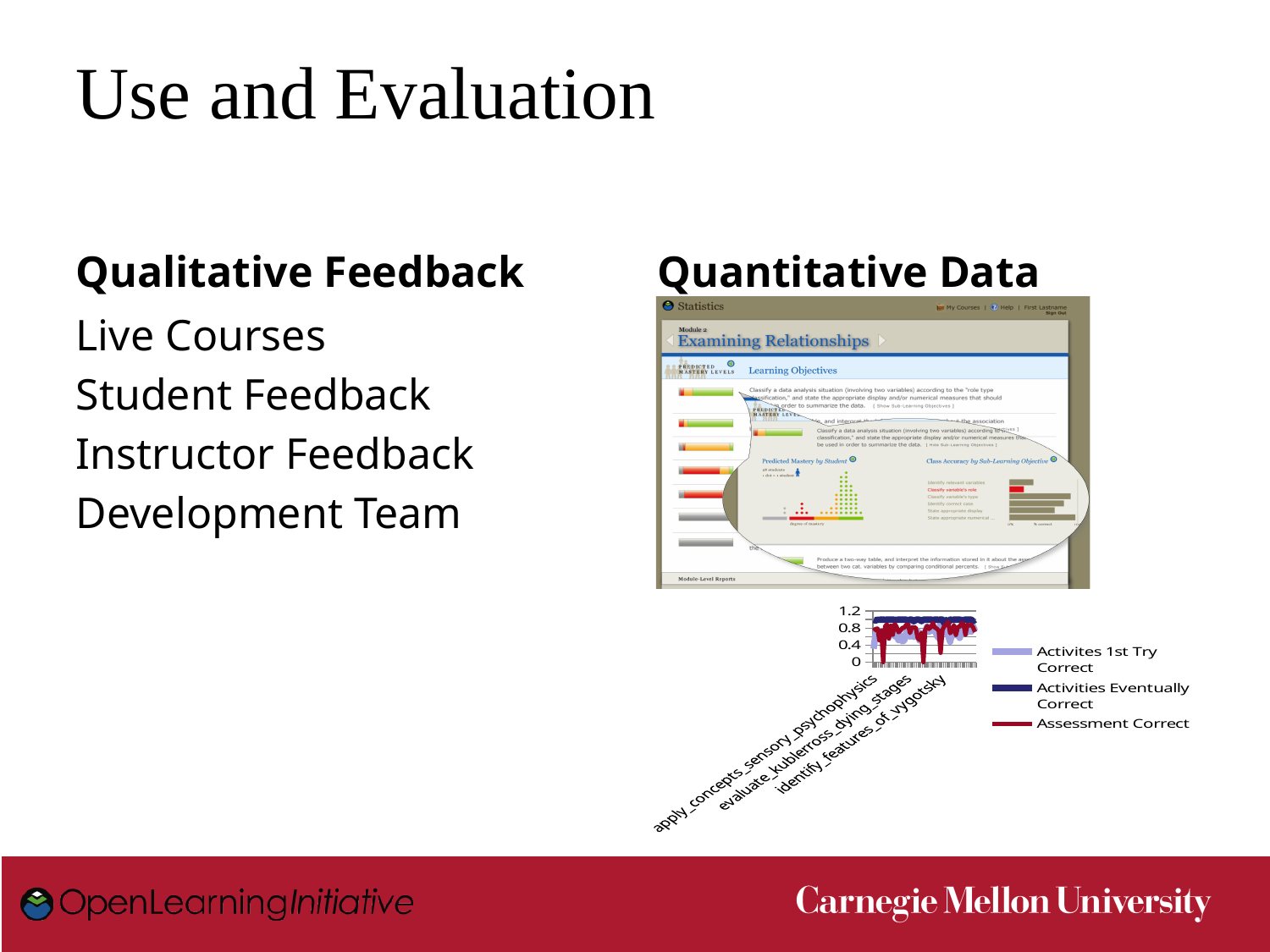
Which heading on the slide sits above the screenshot and the line chart? Quantitative Data What is the lowest tick value shown on the y axis of the bottom-right chart? 0 What is the highest tick value shown on the y axis of the bottom-right chart? 1.2 In the bottom-right chart, which series is drawn in dark navy according to the legend? Activities Eventually Correct What kind of chart is shown at the bottom right of the slide, under the 'Quantitative Data' heading? line chart In the bottom-right chart, which series is drawn in red according to the legend? Assessment Correct How many series does the legend of the bottom-right chart list? 3